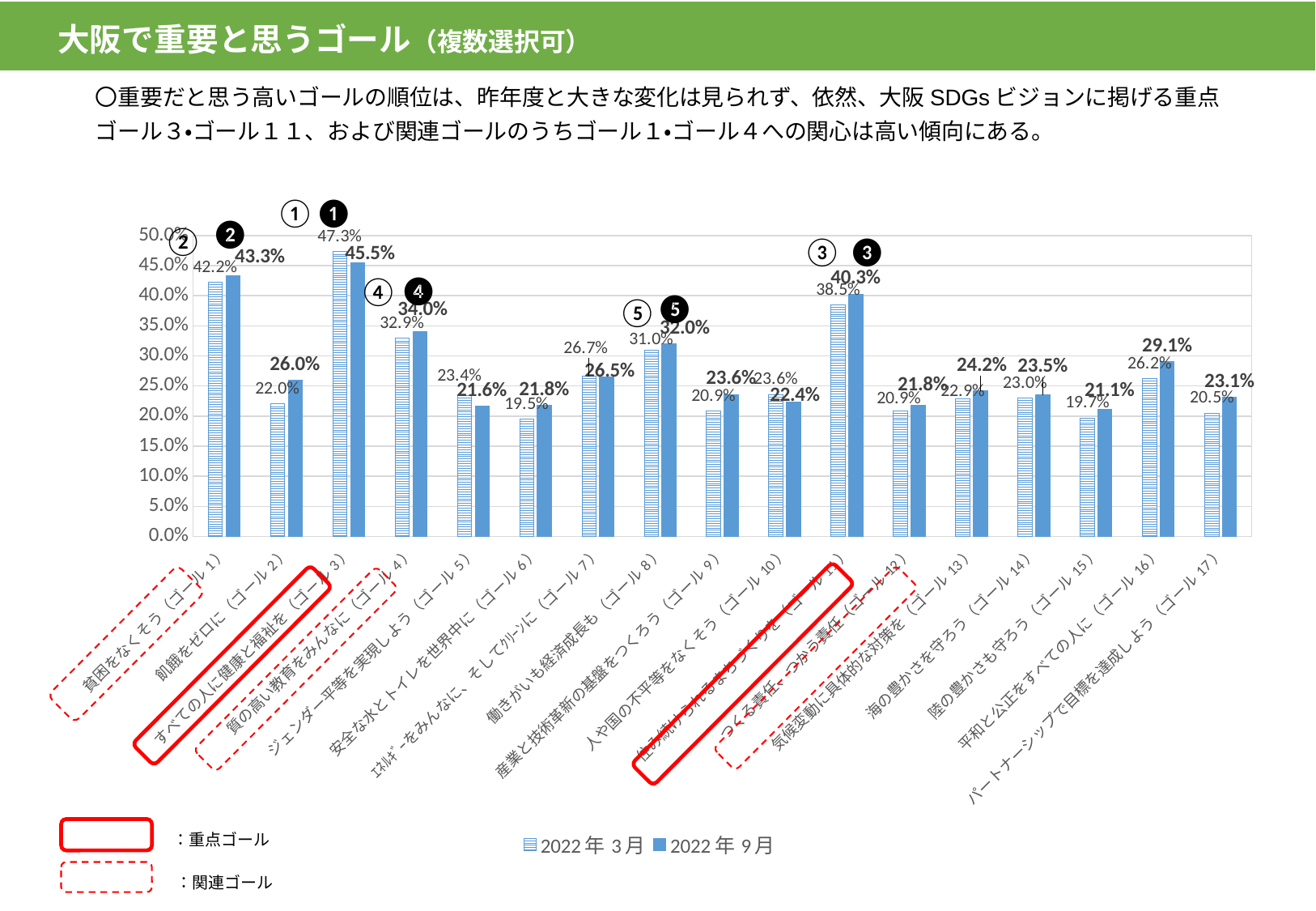
Is the 2022年9月 value for ゴール1 greater or less than 40.0%? greater What is the difference between the 2022年9月 and 2022年3月 values for ゴール16? 2.9% What is the 2022年9月 value for ゴール2 (飢餓をゼロに)? 26.0% Which goal has the lowest 2022年3月 value? ゴール6 (安全な水とトイレを世界中に) What are the two series listed in the legend? 2022年3月 and 2022年9月 For ゴール3, which is larger: the 2022年3月 value or the 2022年9月 value? 2022年3月 What is the 2022年3月 value for ゴール11? 38.5% What is the 2022年9月 value for ゴール3 (すべての人に健康と福祉を)? 45.5% How many goals (categories) are shown on the x axis? 17 Which goal has the highest 2022年9月 value? ゴール3 (すべての人に健康と福祉を) How many series does the legend list? 2 What kind of chart is shown on the slide? bar chart